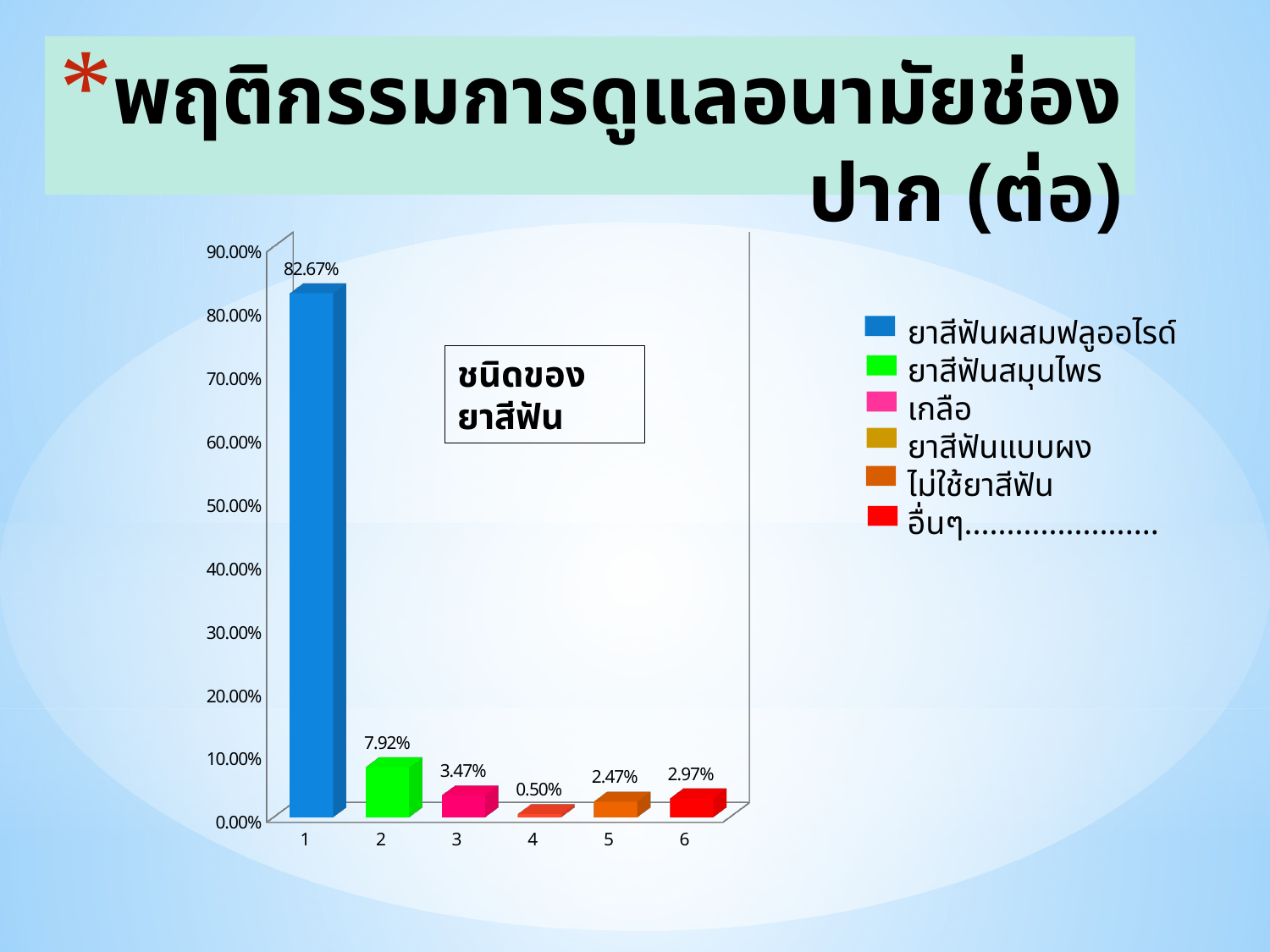
What is the value for category 2? 7.92% What is the value for category 6? 2.97% Which is larger, the value for category 5 or category 6? category 6 Which category has the highest value? 1 How many categories are plotted on the x axis? 6 Is the value for category 1 greater or less than 80.00%? greater How many entries does the legend list? 6 Which category has the lowest value? 4 What is the value for category 4? 0.50% What is the difference between the values for category 2 and category 3? 4.45% What is the value for category 1? 82.67% What kind of chart is shown on the slide? bar chart